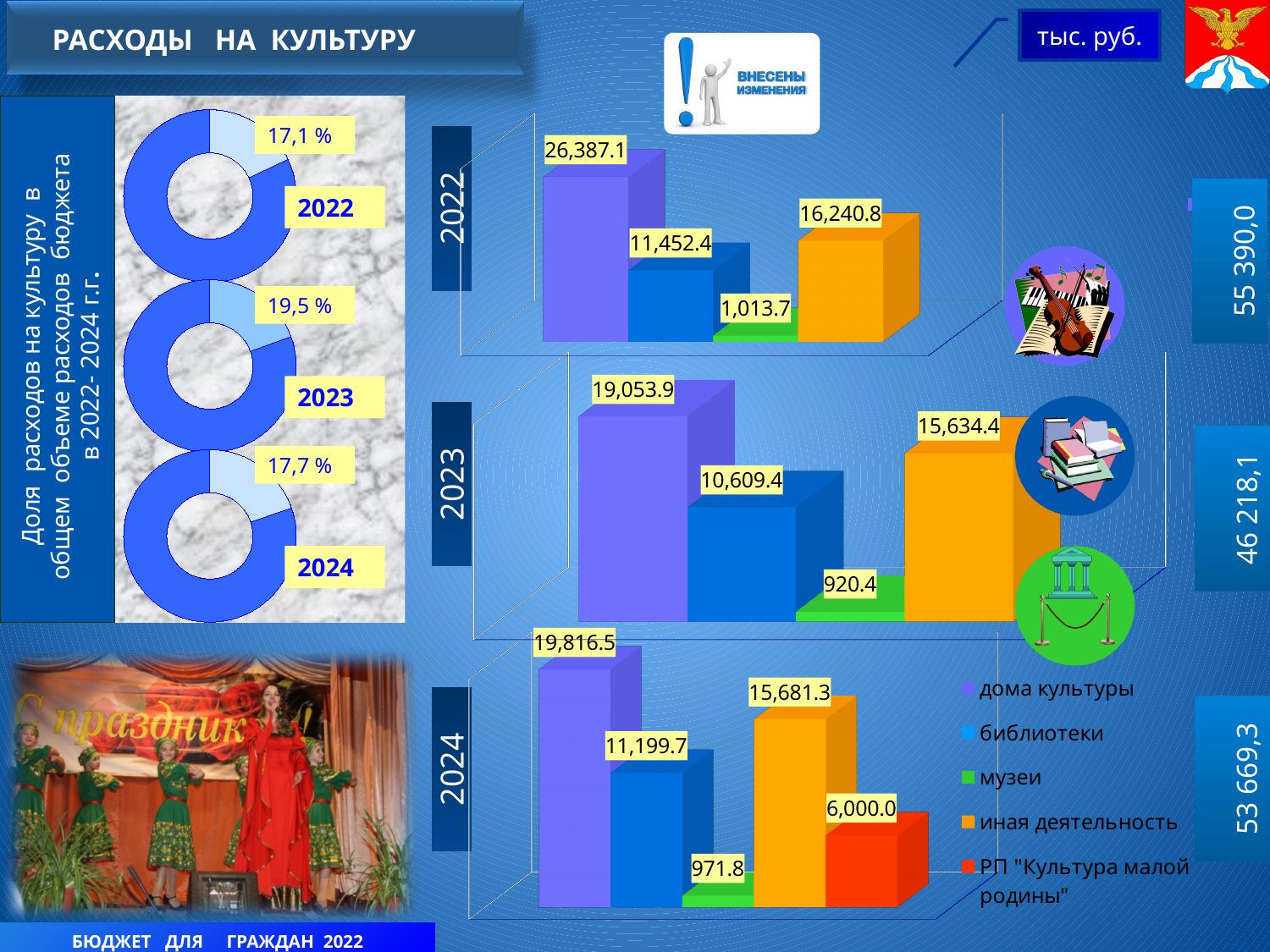
In the donut charts on the left, what share is shown for 2023? 19,5 % In the 2024 bar chart, which category has the highest value? дома культуры In the 2022 bar chart, what is the value for дома культуры? 26,387.1 In the 2024 bar chart, what is the difference between иная деятельность and РП "Культура малой родины"? 9,681.3 How many series does the legend of the bar charts list? 5 What kind of chart is used to show the 2022, 2023 and 2024 expenditure values on the right side of the slide? bar chart In the 2023 bar chart, which is larger: иная деятельность or библиотеки? иная деятельность How many bars are in the 2024 bar chart? 5 In the 2024 bar chart, what is the value for РП "Культура малой родины"? 6,000.0 In the 2022 bar chart, what is the difference between дома культуры and библиотеки? 14,934.7 In the 2022 bar chart, which category has the lowest value? музеи In the 2023 bar chart, what is the value for библиотеки? 10,609.4